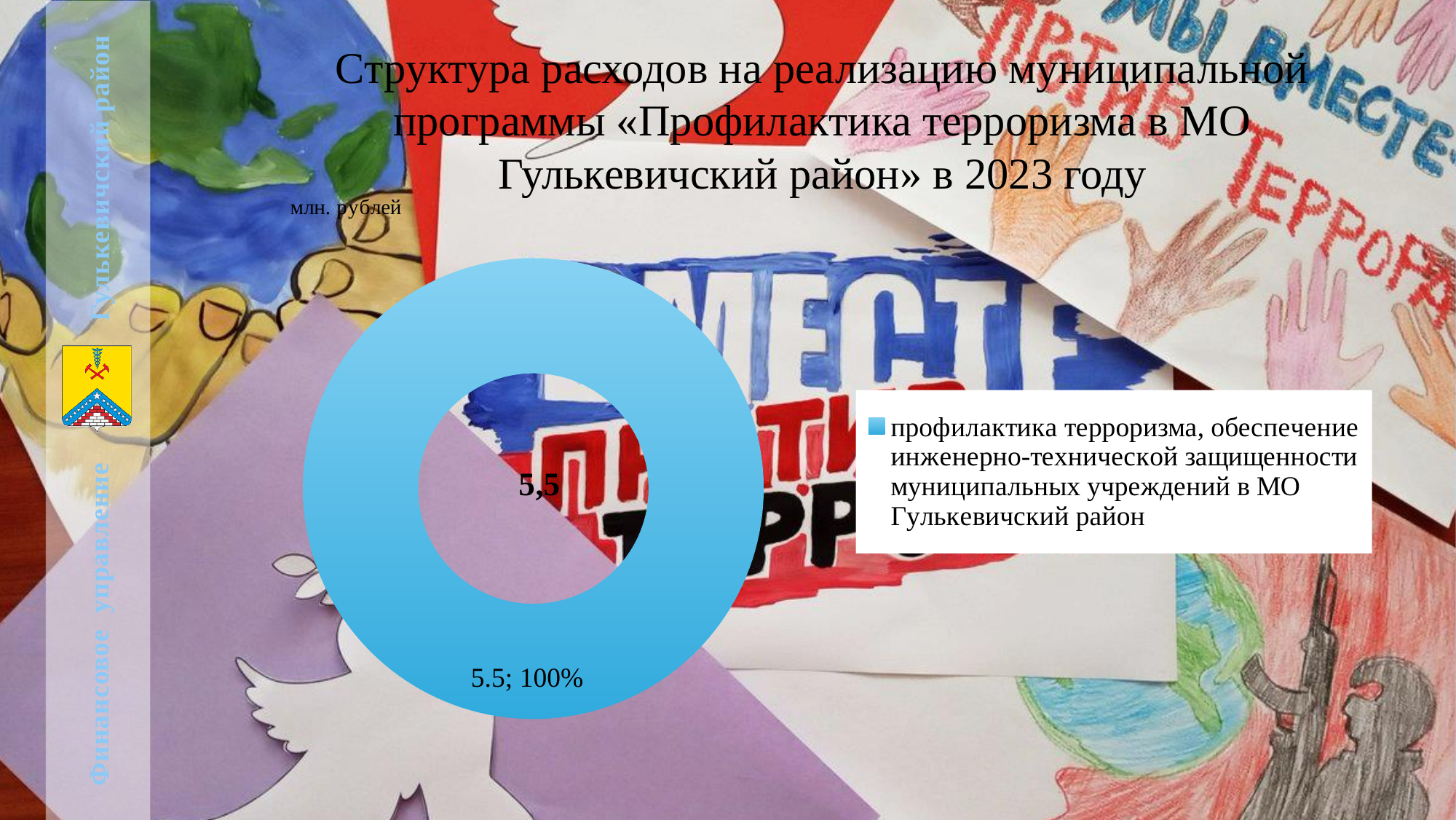
How many slices does the doughnut chart have? 1 What share of the doughnut chart does the slice for «профилактика терроризма, обеспечение инженерно-технической защищенности муниципальных учреждений в МО Гулькевичский район» represent? 100% What value is shown on the data label of the doughnut chart slice? 5.5 What is the total of all slices in the doughnut chart? 5.5 What is the legend entry of the chart? профилактика терроризма, обеспечение инженерно-технической защищенности муниципальных учреждений в МО Гулькевичский район What value is printed in the centre of the doughnut chart? 5,5 Is the value of the doughnut chart slice greater or less than 5? greater What kind of chart is shown on the slide? doughnut chart What unit of measurement is indicated for the chart values? млн. рублей How many entries does the legend of the chart list? 1